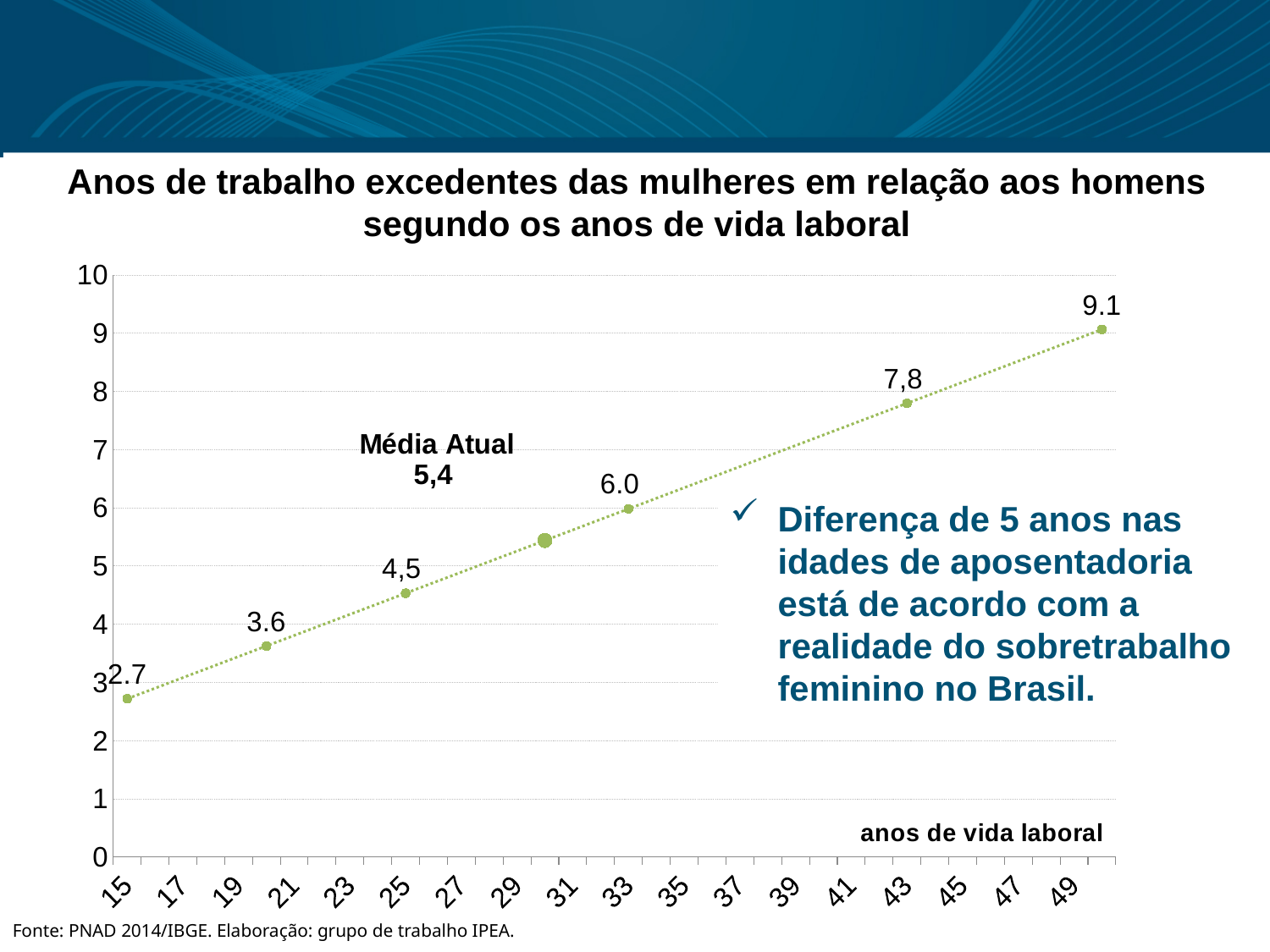
What is the difference between the highest labelled value (9.1) and the lowest labelled value (2.7)? 6.4 How many data points carry a value label on the chart? 7 What value is labelled as 'Média Atual' on the chart? 5,4 What is the highest labelled value on the line? 9.1 What is the lowest labelled value on the line? 2.7 What is the label shown for the x axis of the chart? anos de vida laboral Do the values rise or fall as the years of working life increase along the x axis? rise What is the title of the chart? Anos de trabalho excedentes das mulheres em relação aos homens segundo os anos de vida laboral What kind of chart is shown on the slide? line chart Which is larger, the point labelled 7,8 or the point labelled 6.0? 7,8 Is the value of the point labelled 4,5 greater or less than 5? less What is the value of the first data point, at 15 years of working life? 2.7